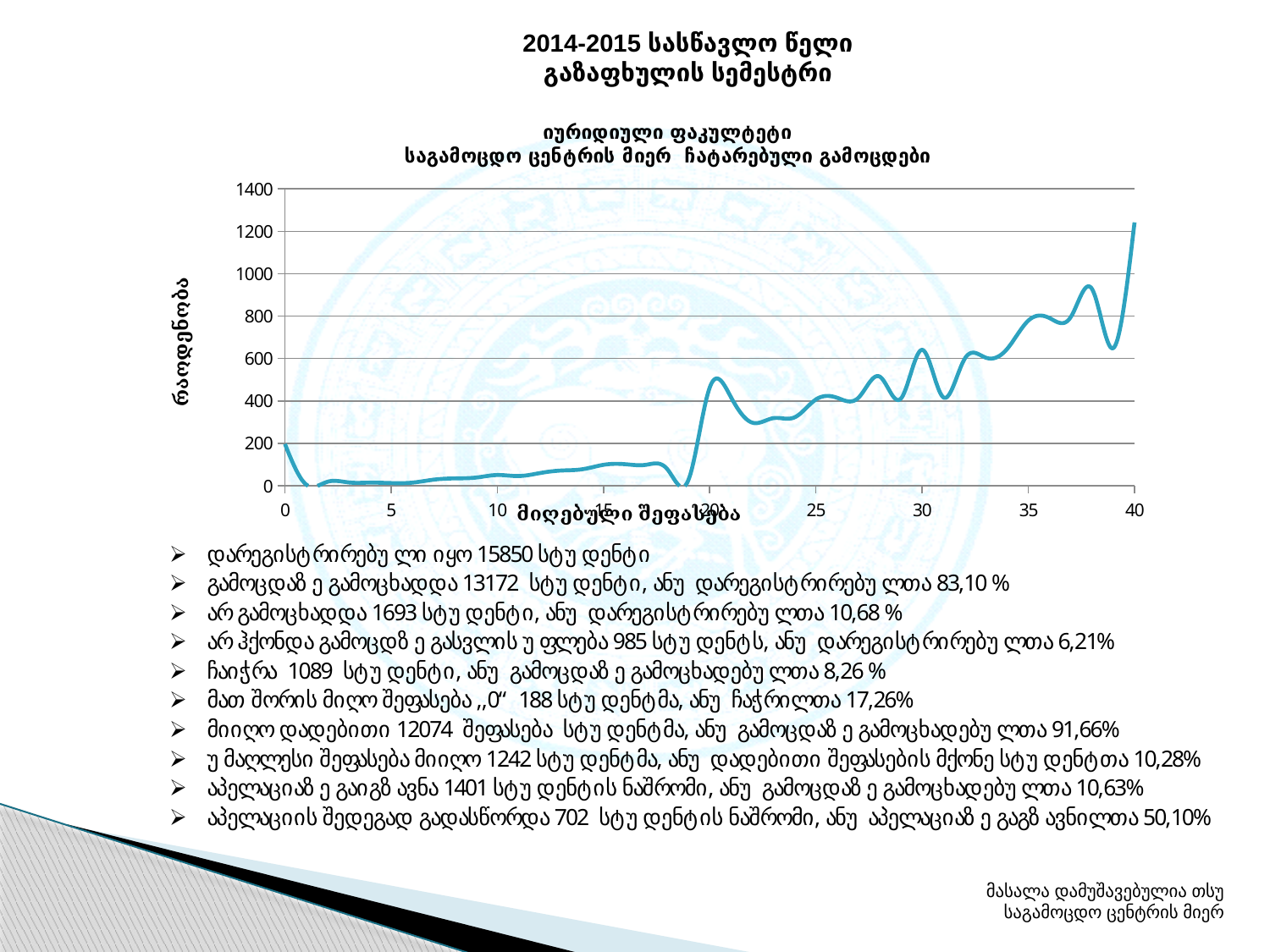
Is the value of the line at score 35 greater or less than 600? greater Is the value of the line at score 40 greater or less than 1000? greater What is the label of the horizontal axis of the chart? მიღებული შეფასება Is the value of the line at score 25 greater or less than 600? less At which score on the horizontal axis does the line reach its highest value? 40 What is the highest value shown on the vertical axis of the chart? 1400 Overall, does the line rise or fall as the score increases from 0 to 40? rises What is the label of the vertical axis of the chart? რაოდენობა What kind of chart is shown on the slide? line chart